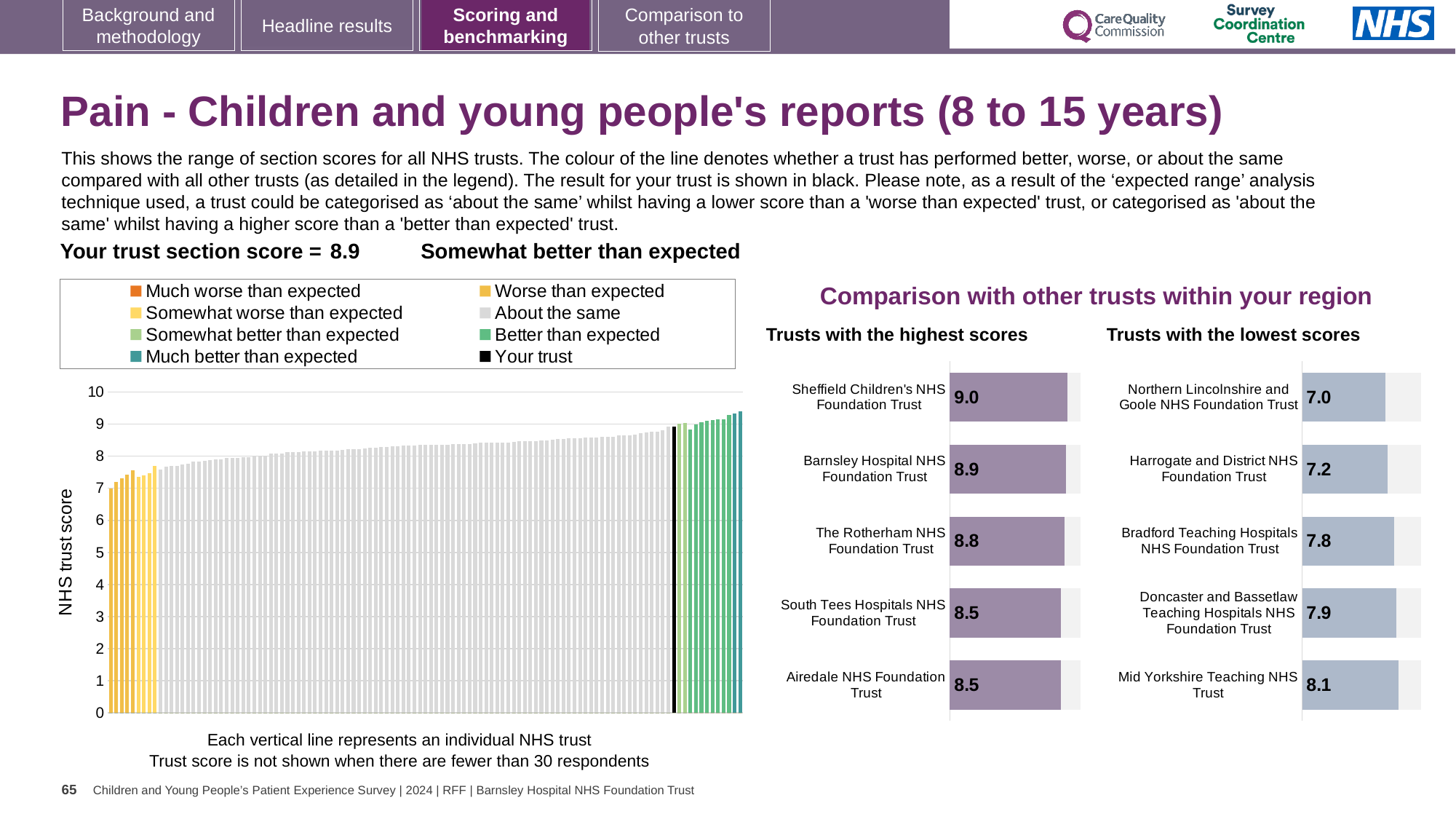
In the 'Trusts with the lowest scores' chart, what is the difference between the scores of Mid Yorkshire Teaching NHS Trust and Northern Lincolnshire and Goole NHS Foundation Trust? 1.1 In the 'Trusts with the lowest scores' chart, what is the score for Harrogate and District NHS Foundation Trust? 7.2 How many trusts are listed in the 'Trusts with the highest scores' chart? 5 What type of chart is the large 'NHS trust score' chart on the left? Bar chart In the large 'NHS trust score' chart on the left, do the bar values rise or fall from left to right? Rise In the 'Trusts with the highest scores' chart, what is the score for Sheffield Children's NHS Foundation Trust? 9.0 In the 'Trusts with the lowest scores' chart, which trust has the lowest score? Northern Lincolnshire and Goole NHS Foundation Trust In the 'Trusts with the lowest scores' chart, which has the higher score: Bradford Teaching Hospitals NHS Foundation Trust or Harrogate and District NHS Foundation Trust? Bradford Teaching Hospitals NHS Foundation Trust How many entries does the legend of the large 'NHS trust score' chart on the left list? 8 In the large 'NHS trust score' chart on the left, is the value of the tallest bar greater or less than 10? less In the 'Trusts with the highest scores' chart, which trust has the highest score? Sheffield Children's NHS Foundation Trust In the 'Trusts with the highest scores' chart, what is the difference between the scores of Sheffield Children's NHS Foundation Trust and The Rotherham NHS Foundation Trust? 0.2